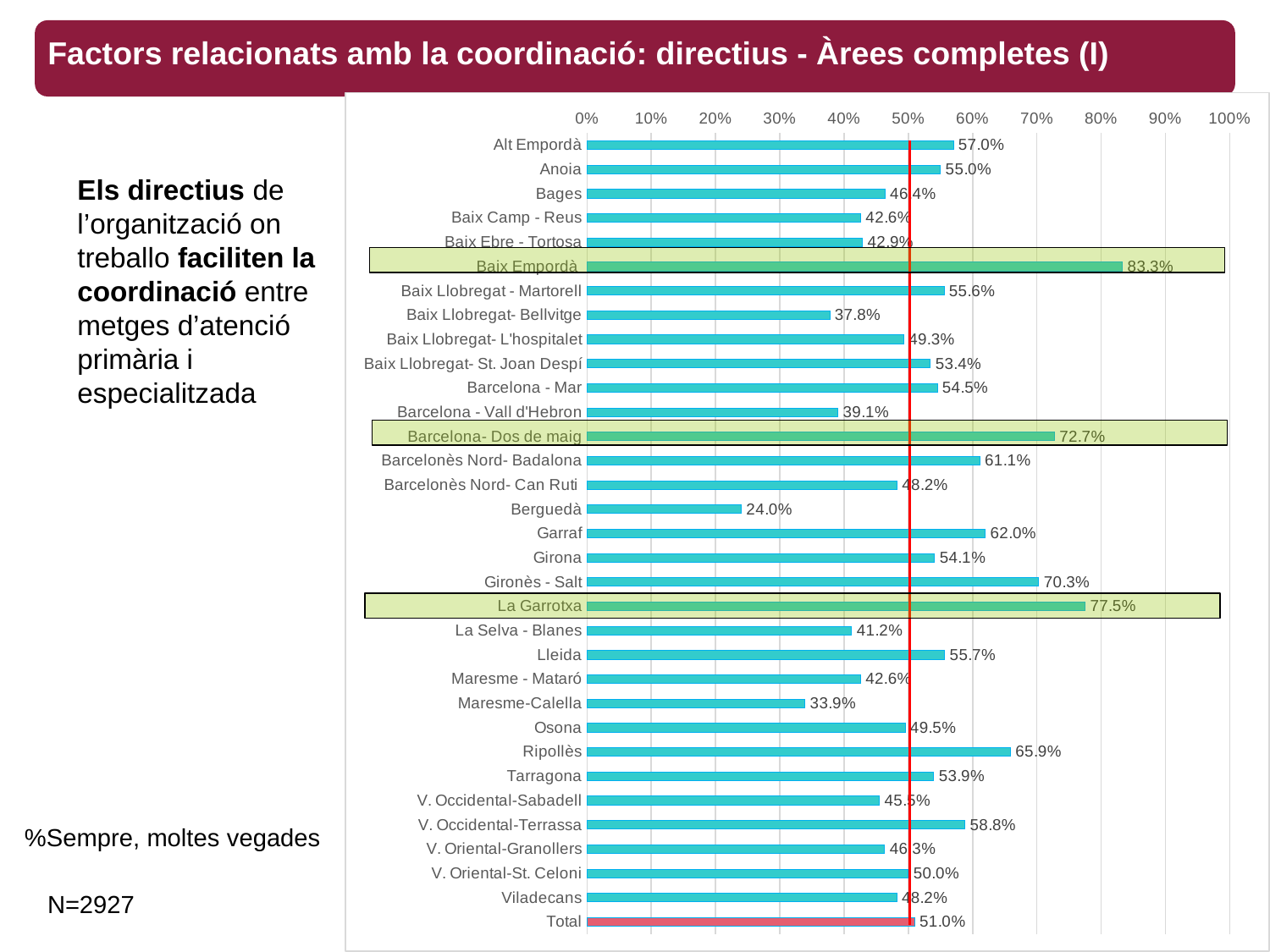
What is the value for Total? 51.0% Which three categories are highlighted with a green background in the chart? Baix Empordà, Barcelona- Dos de maig, La Garrotxa How many bars are shown in the chart, including Total? 33 What is the value for Ripollès? 65.9% Which has a larger value, Ripollès or Garraf? Ripollès What kind of chart is shown on the slide? Bar chart What is the difference between the values for Baix Empordà and Berguedà? 59.3 percentage points Which category has the highest value? Baix Empordà Which category has the lowest value? Berguedà What is the difference between the values for Garraf and Girona? 7.9 percentage points Is the value for Berguedà greater or less than 30%? less What is the value for Baix Empordà? 83.3%